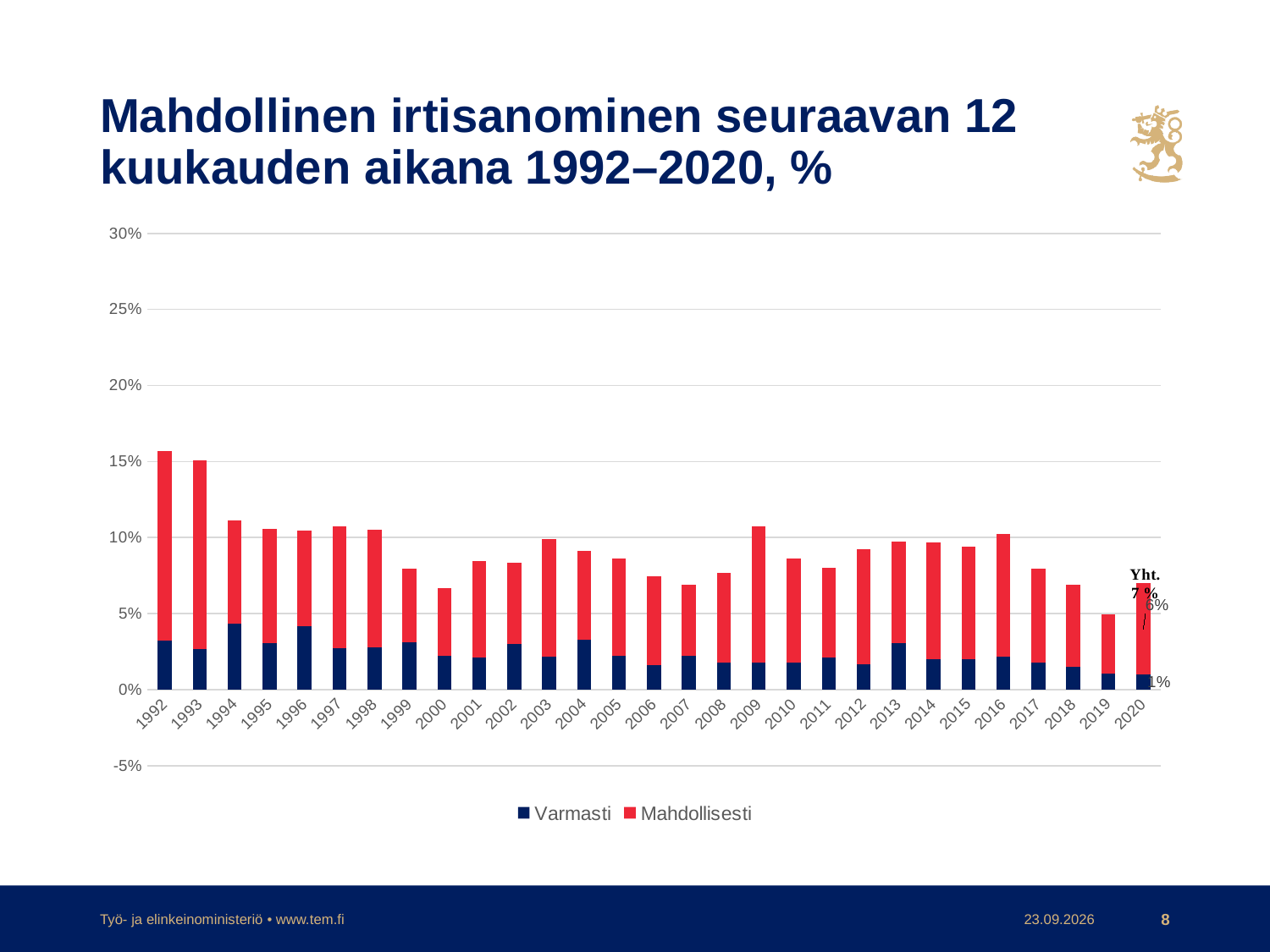
Is the total value for 2000 greater or less than 10%? less What is the value of Varmasti for 2020? 1% Is the total value for 1992 greater or less than 10%? greater How many series does the legend list? 2 Which year has the lowest total bar? 2019 What is the total (Yht.) of the stacked bar for 2020? 7 % What kind of chart is shown on the slide? Stacked bar chart Which series is shown in red in the legend? Mahdollisesti What is the value of Mahdollisesti for 2020? 6% Which year has a larger total bar, 1993 or 2006? 1993 How many years are shown on the x axis? 29 Which year has the highest total bar? 1992